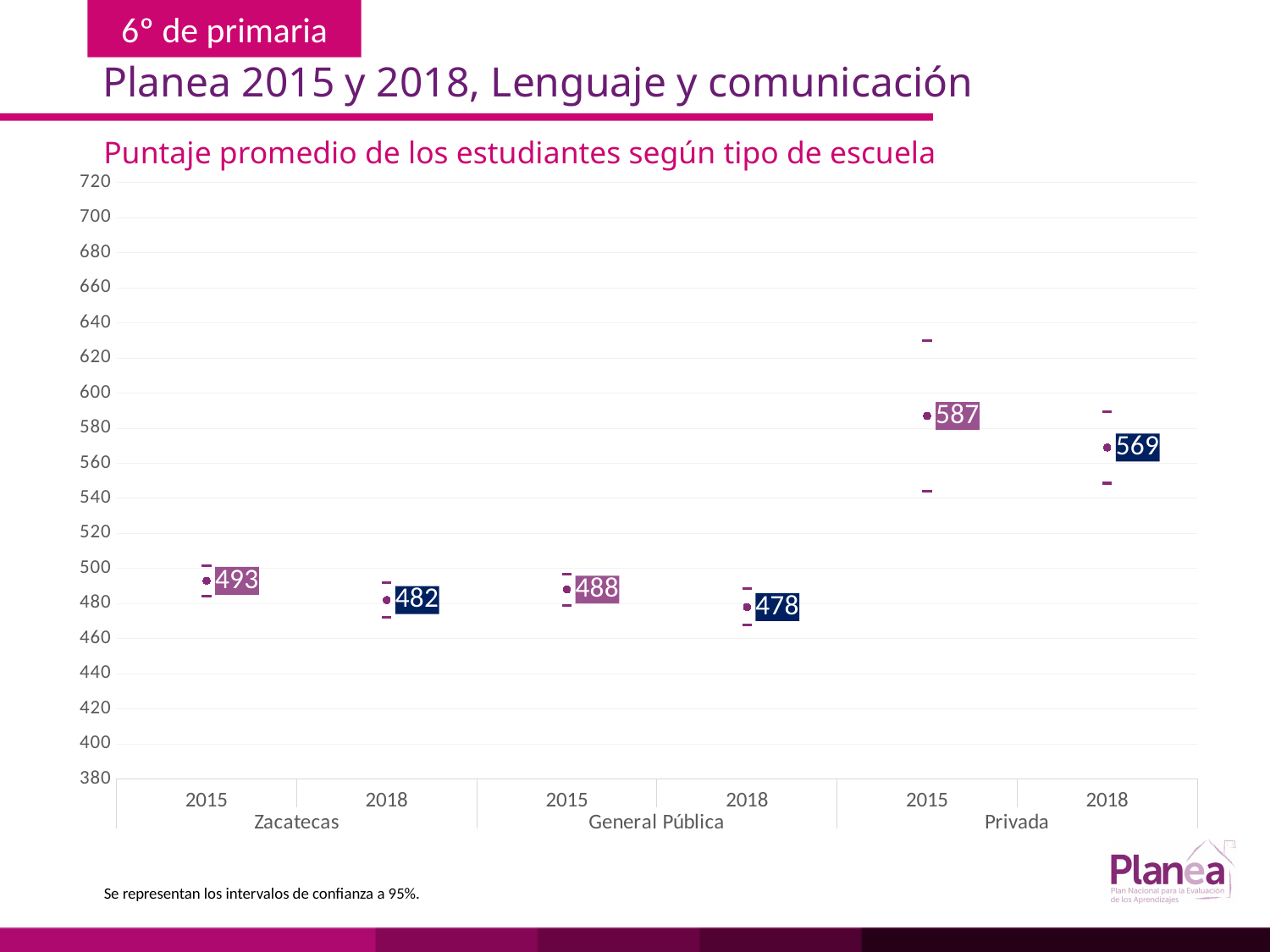
How many data points are plotted on the chart? 6 Which is larger, the Zacatecas 2018 score or the General Pública 2018 score? Zacatecas 2018 What is the average score for Zacatecas in 2018? 482 What is the difference between the Zacatecas scores in 2015 and 2018? 11 What is the average score for Privada in 2018? 569 Which group and year has the highest average score? Privada 2015 What is the title of the chart? Puntaje promedio de los estudiantes según tipo de escuela What is the difference between the Privada scores in 2015 and 2018? 18 What is the average score for General Pública in 2015? 488 What is the average score for Zacatecas in 2015? 493 Which group and year has the lowest average score? General Pública 2018 Did the Privada average score rise or fall from 2015 to 2018? fall